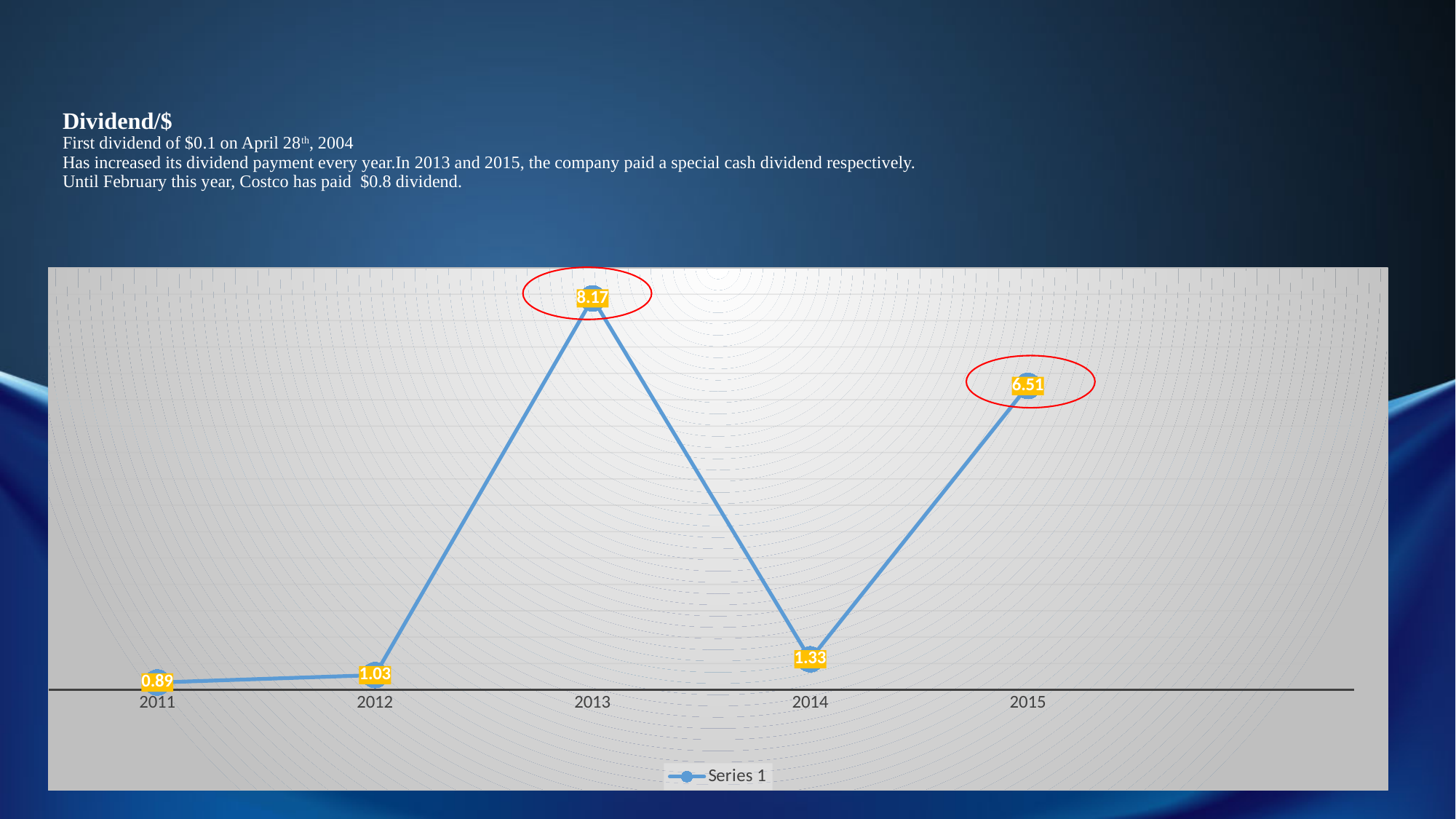
Which year has the lowest value? 2011 What is the name of the series shown in the legend? Series 1 Which is larger, the value for 2014 or the value for 2012? 2014 What kind of chart is shown on the slide? line chart What is the difference between the values for 2013 and 2015? 1.66 How many years are plotted on the chart? 5 What is the difference between the values for 2012 and 2011? 0.14 What is the value for 2013? 8.17 What is the value for 2015? 6.51 Which year has the highest value? 2013 What is the value for 2014? 1.33 What is the value for 2011? 0.89